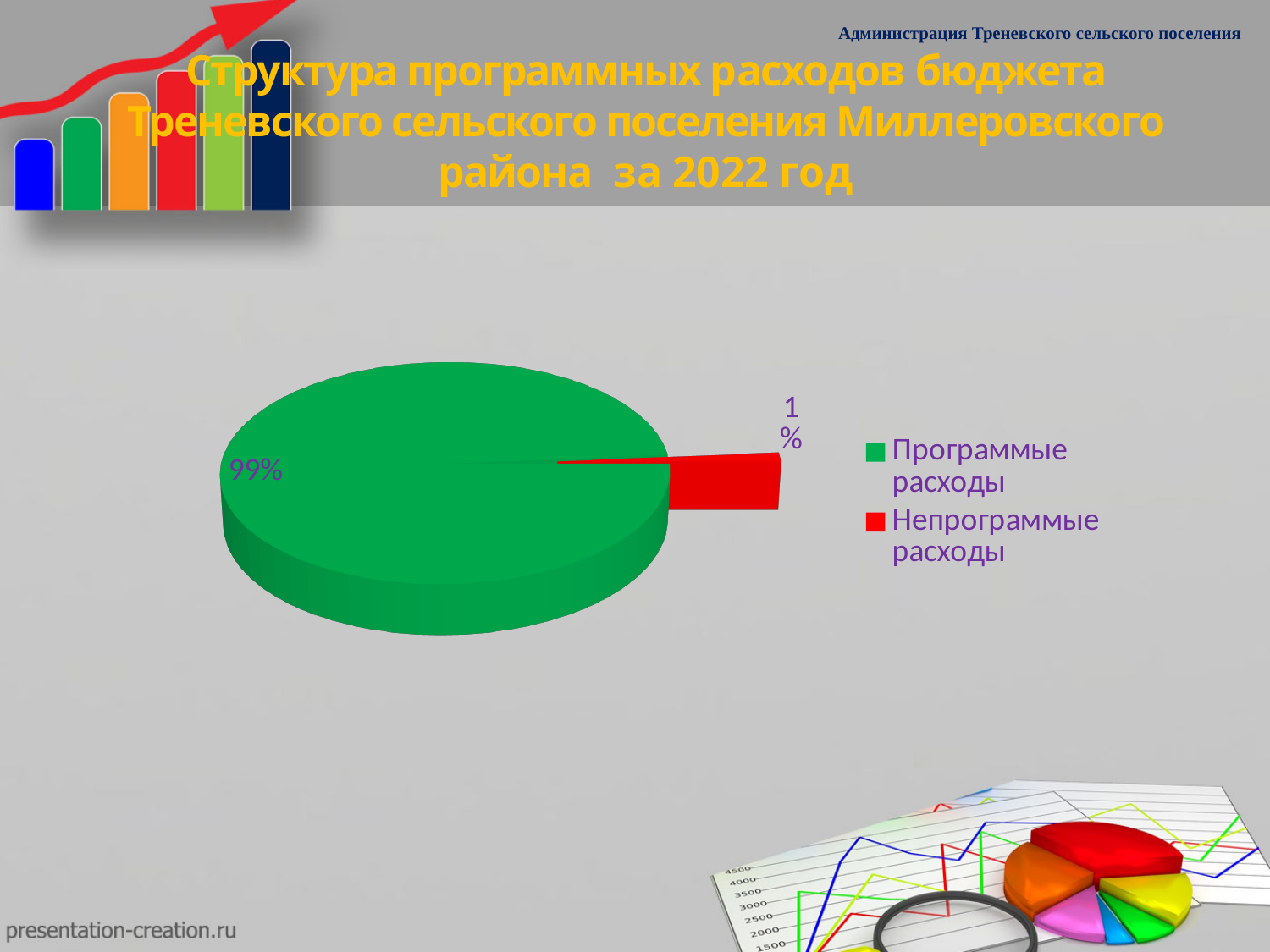
What is the difference in percentage points between Программые расходы and Непрограммые расходы? 98 Which category has the largest slice of the pie? Программые расходы What share of the pie is labelled for Программые расходы? 99% How many categories does the legend list? 2 Which is larger, the slice for Программые расходы or the slice for Непрограммые расходы? Программые расходы What colour is the slice for Программые расходы? green How many slices does the pie chart have? 2 What share of the pie is labelled for Непрограммые расходы? 1% What colour is the slice for Непрограммые расходы? red Which category has the smallest slice of the pie? Непрограммые расходы What kind of chart is shown on the slide? pie chart